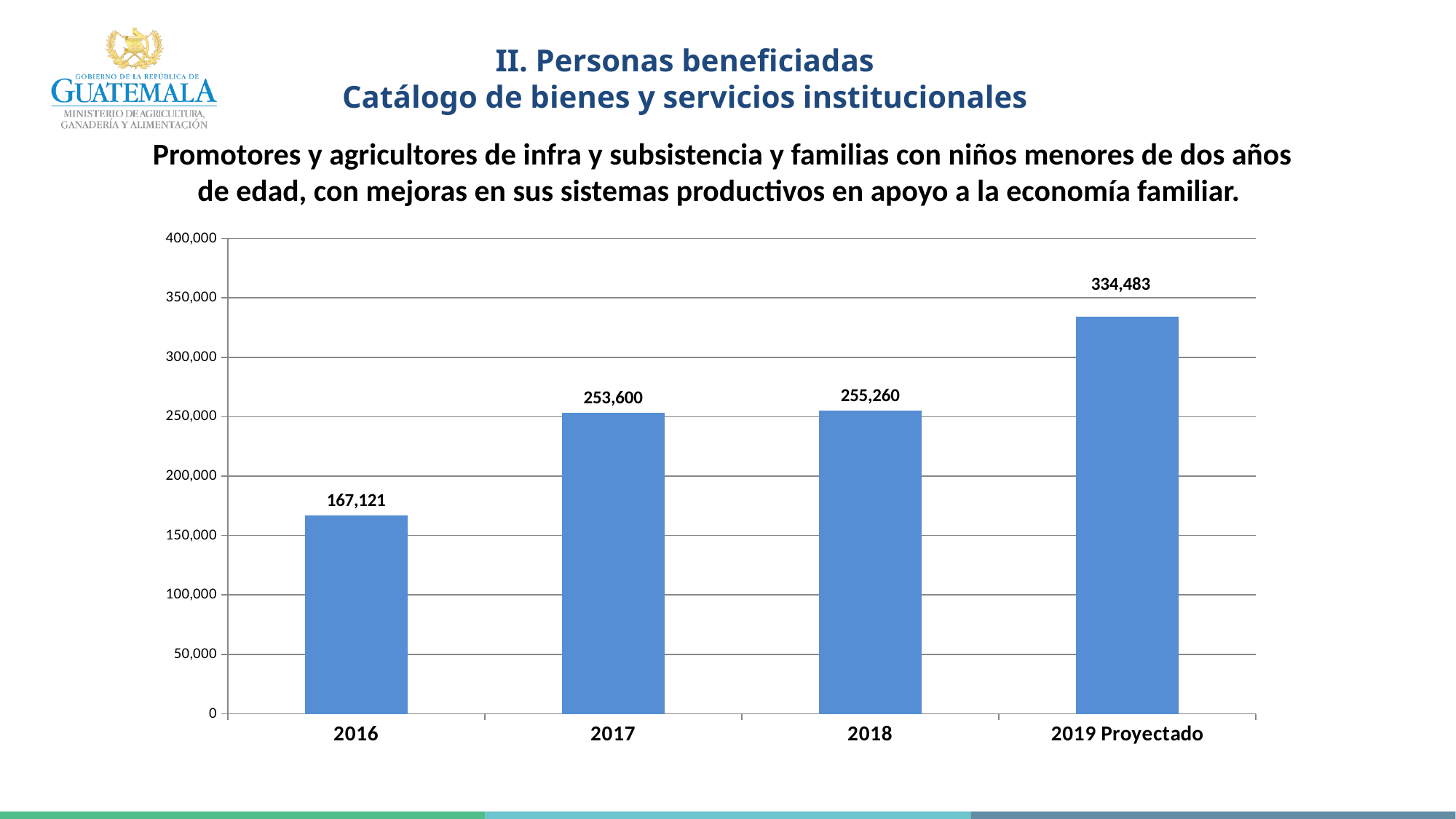
Which category has the lowest value? 2016 Which category has the highest value? 2019 Proyectado How many categories are shown on the x axis? 4 Is the value for 2019 Proyectado greater or less than 300,000? greater What is the difference between the values for 2017 and 2016? 86,479 What is the value for 2019 Proyectado? 334,483 What is the difference between the values for 2019 Proyectado and 2016? 167,362 What is the value for 2017? 253,600 What is the value for 2016? 167,121 Which is larger, the value for 2016 or the value for 2017? 2017 What kind of chart is shown on the slide? bar chart What is the value for 2018? 255,260